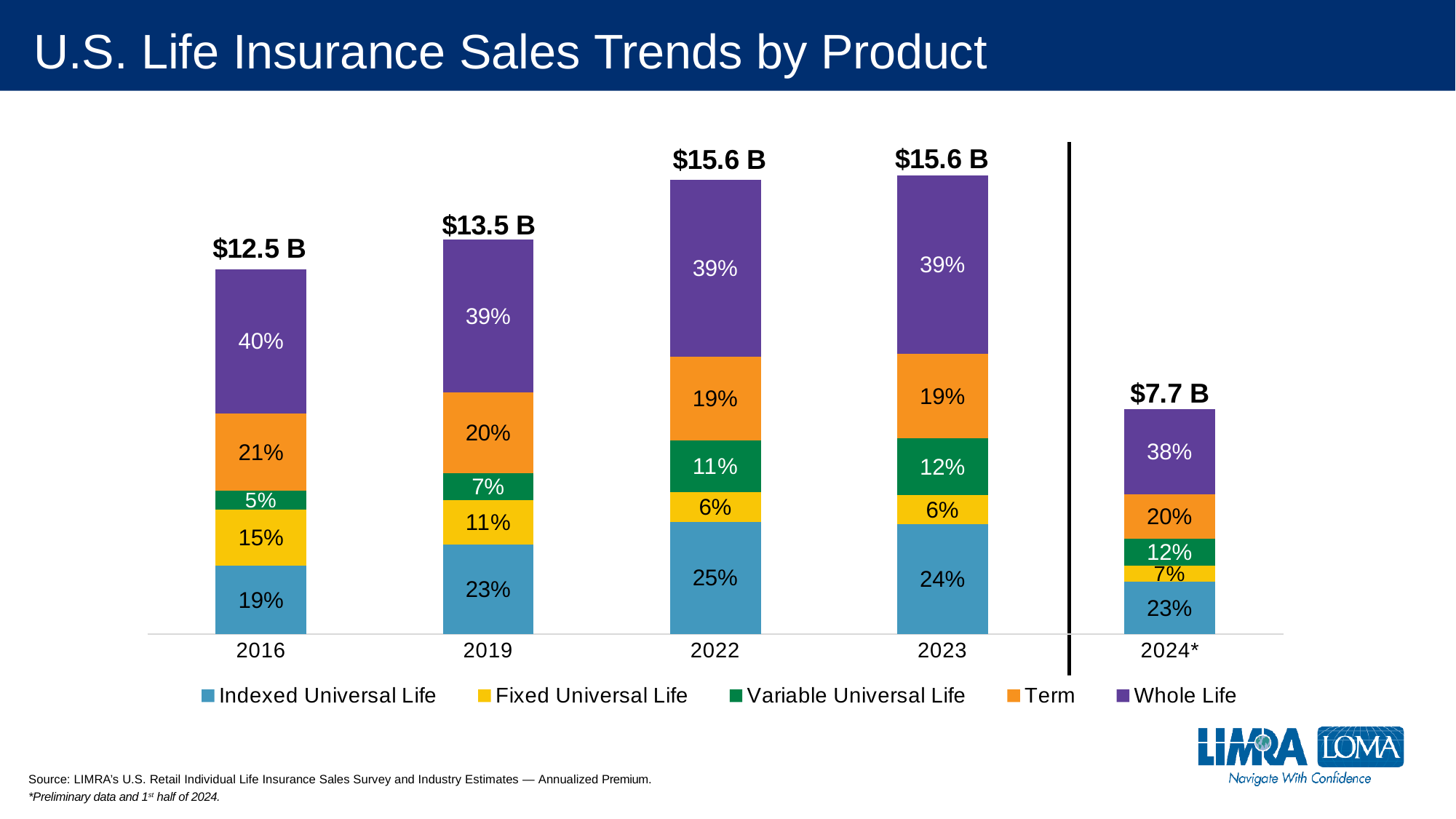
What is the total annualized premium shown above the 2023 bar? $15.6 B What kind of chart is shown on the slide? Stacked bar chart What share of sales did Variable Universal Life account for in 2019? 7% How many years are shown on the x axis? 5 What is the difference in percentage points between the Fixed Universal Life share in 2016 and in 2019? 4 percentage points Which year has the lowest total annualized premium? 2024* Which product has the largest share of sales in 2022? Whole Life What share of sales did Indexed Universal Life account for in 2022? 25% What share of sales did Whole Life account for in 2016? 40% How many series does the legend list? 5 Which is larger in 2023: the Term share or the Variable Universal Life share? Term What share of sales did Term account for in 2024*? 20%